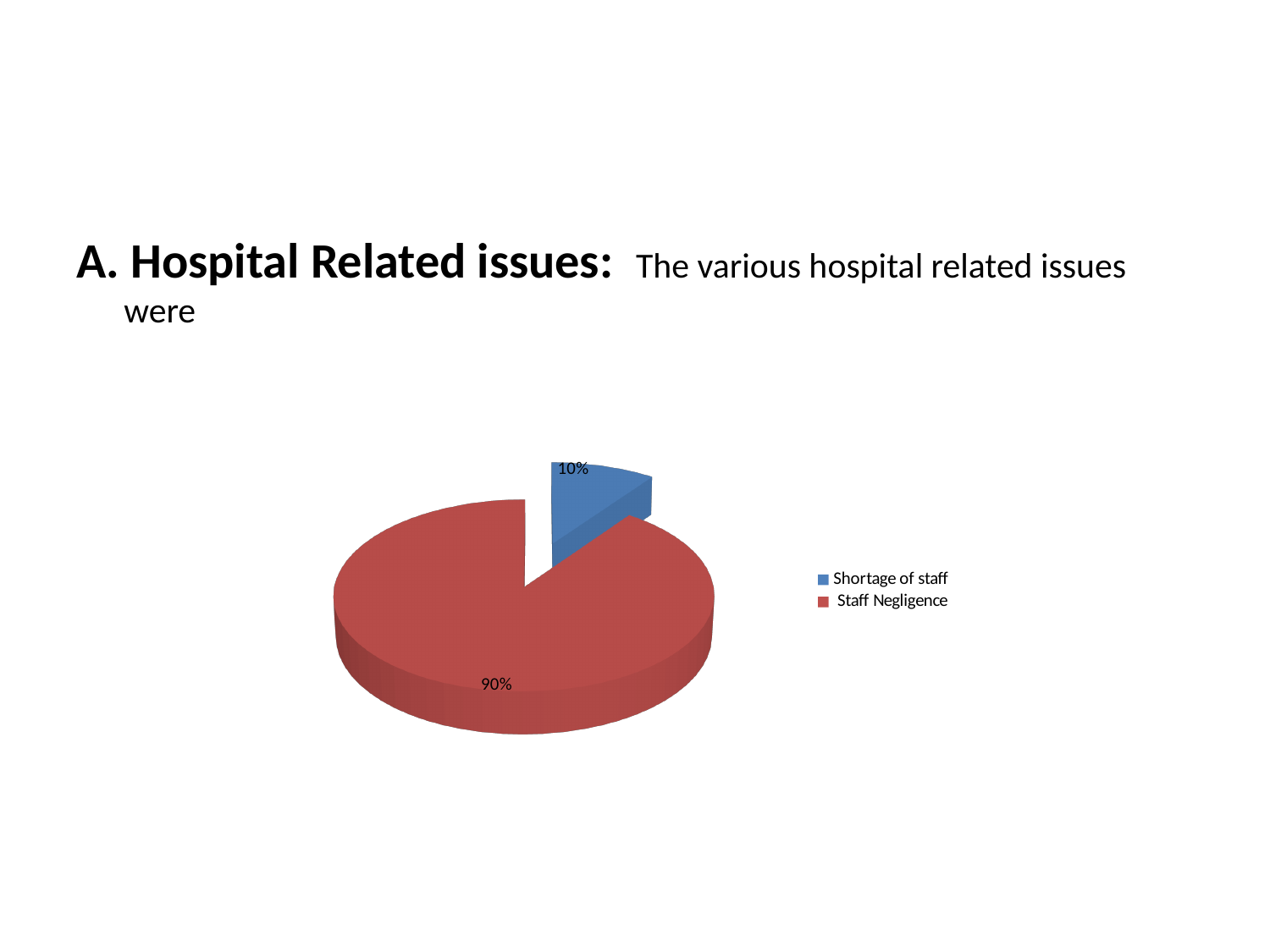
What colour is the Staff Negligence slice? Red What percentage of the pie chart is Staff Negligence? 90% What kind of chart is shown on the slide? Pie chart What colour is the Shortage of staff slice? Blue How many entries does the legend list? 2 Which category has the smallest share of the pie chart? Shortage of staff Which category has the largest share of the pie chart? Staff Negligence What is the difference in percentage points between Staff Negligence and Shortage of staff? 80 How many categories does the pie chart show? 2 What percentage of the pie chart is Shortage of staff? 10% Which is larger, the share for Shortage of staff or the share for Staff Negligence? Staff Negligence